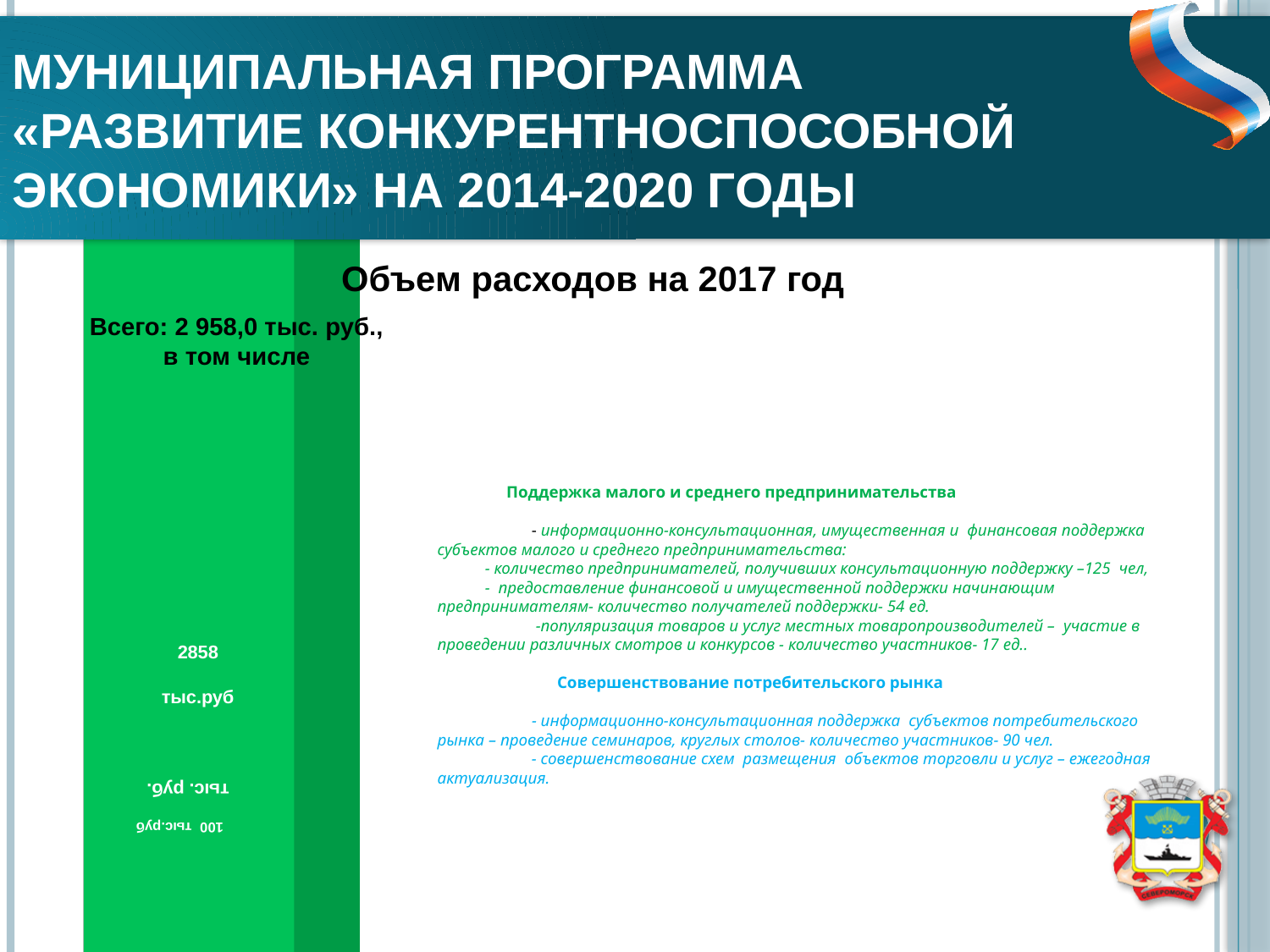
How many segments does the stacked bar have? 2 What is the title of the chart on the slide? Объем расходов на 2017 год What is the total of the stacked bar, as stated on the slide? 2 958,0 тыс. руб. What colour is the bar on the slide? green What is the value of the larger segment of the bar? 2858 тыс.руб Which segment value is larger, 2858 тыс.руб or 100 тыс.руб? 2858 тыс.руб What is the value of the smaller segment of the bar? 100 тыс.руб What is the difference between the two segment values of the bar (2858 and 100 тыс.руб)? 2758 тыс.руб What kind of chart is shown on the slide? bar chart